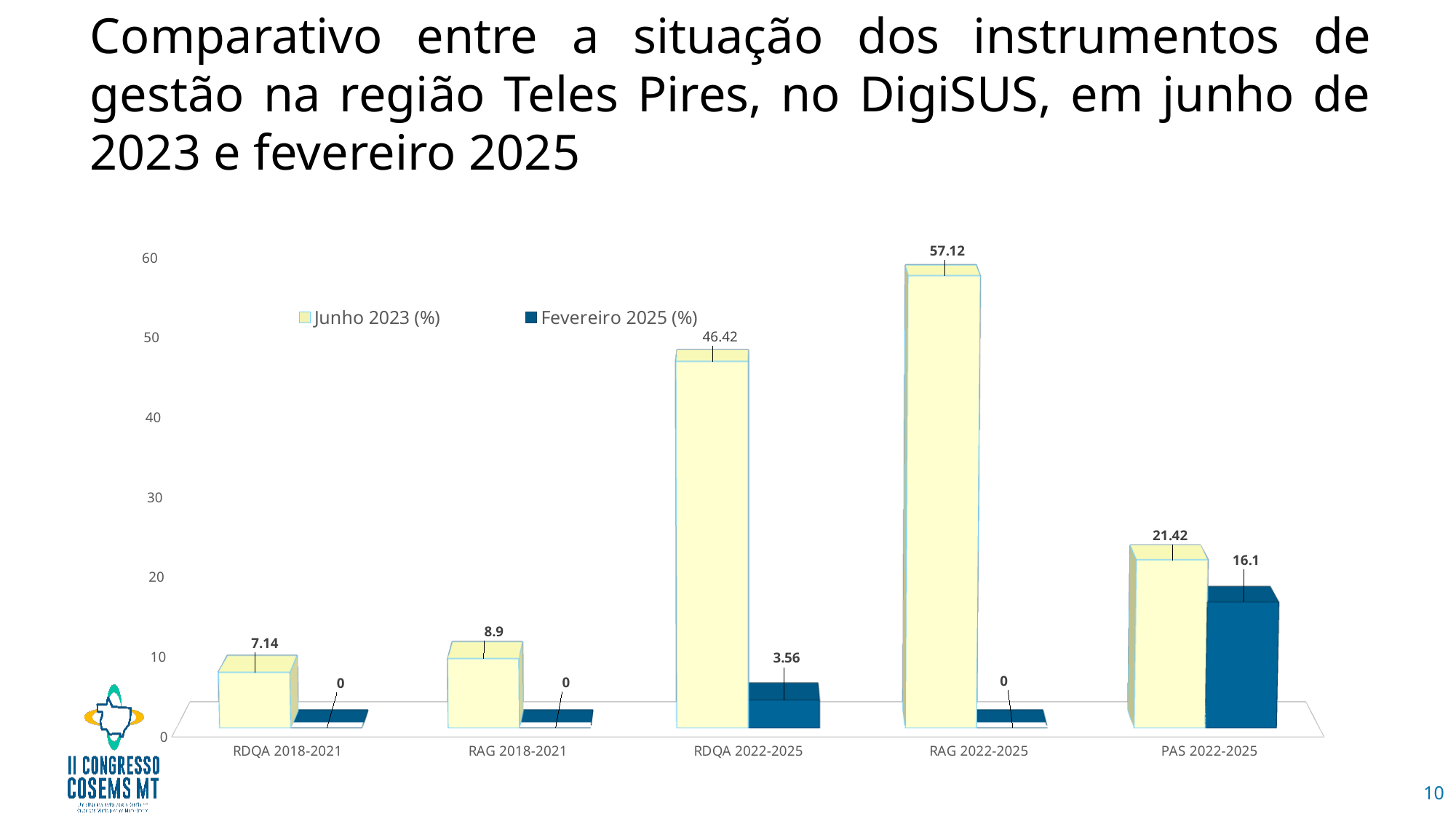
Is the Junho 2023 (%) value for RAG 2022-2025 greater or less than 50? greater Which is larger: the Junho 2023 (%) value for RAG 2018-2021 or for RDQA 2018-2021? RAG 2018-2021 What is the Fevereiro 2025 (%) value for PAS 2022-2025? 16.1 How many categories have a Fevereiro 2025 (%) value of 0? 3 What is the Junho 2023 (%) value for RDQA 2022-2025? 46.42 How many series does the legend list? 2 What kind of chart is shown on the slide? bar chart What is the difference between the Junho 2023 (%) and Fevereiro 2025 (%) values for PAS 2022-2025? 5.32 Which category has the lowest Junho 2023 (%) value? RDQA 2018-2021 Which category has the highest Junho 2023 (%) value? RAG 2022-2025 What is the Fevereiro 2025 (%) value for RDQA 2022-2025? 3.56 How many categories are shown on the x axis? 5